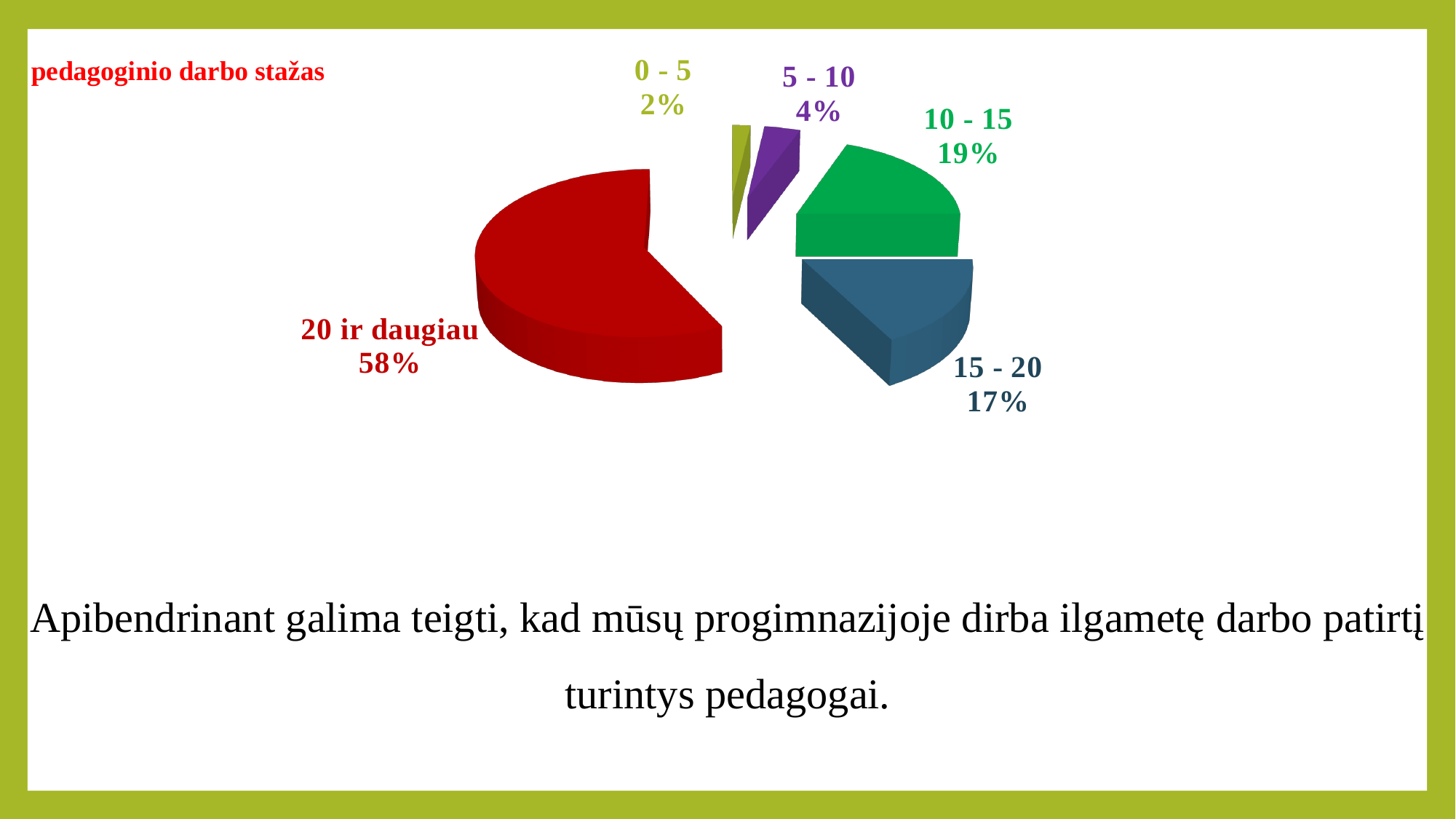
What is the title of the chart? pedagoginio darbo stažas What kind of chart is shown on the slide? pie chart Which category has the smallest slice of the pie? 0 - 5 What is the value shown for the '0 - 5' category? 2% What share of the pie does the '20 ir daugiau' slice represent? 58% What is the value shown for the '15 - 20' category? 17% Which category has the largest slice of the pie? 20 ir daugiau What is the difference in percentage points between the '10 - 15' and '15 - 20' slices? 2 How many categories are shown in the pie chart? 5 Which is larger, the '5 - 10' slice or the '15 - 20' slice? 15 - 20 What is the value shown for the '10 - 15' category? 19% What is the value shown for the '5 - 10' category? 4%